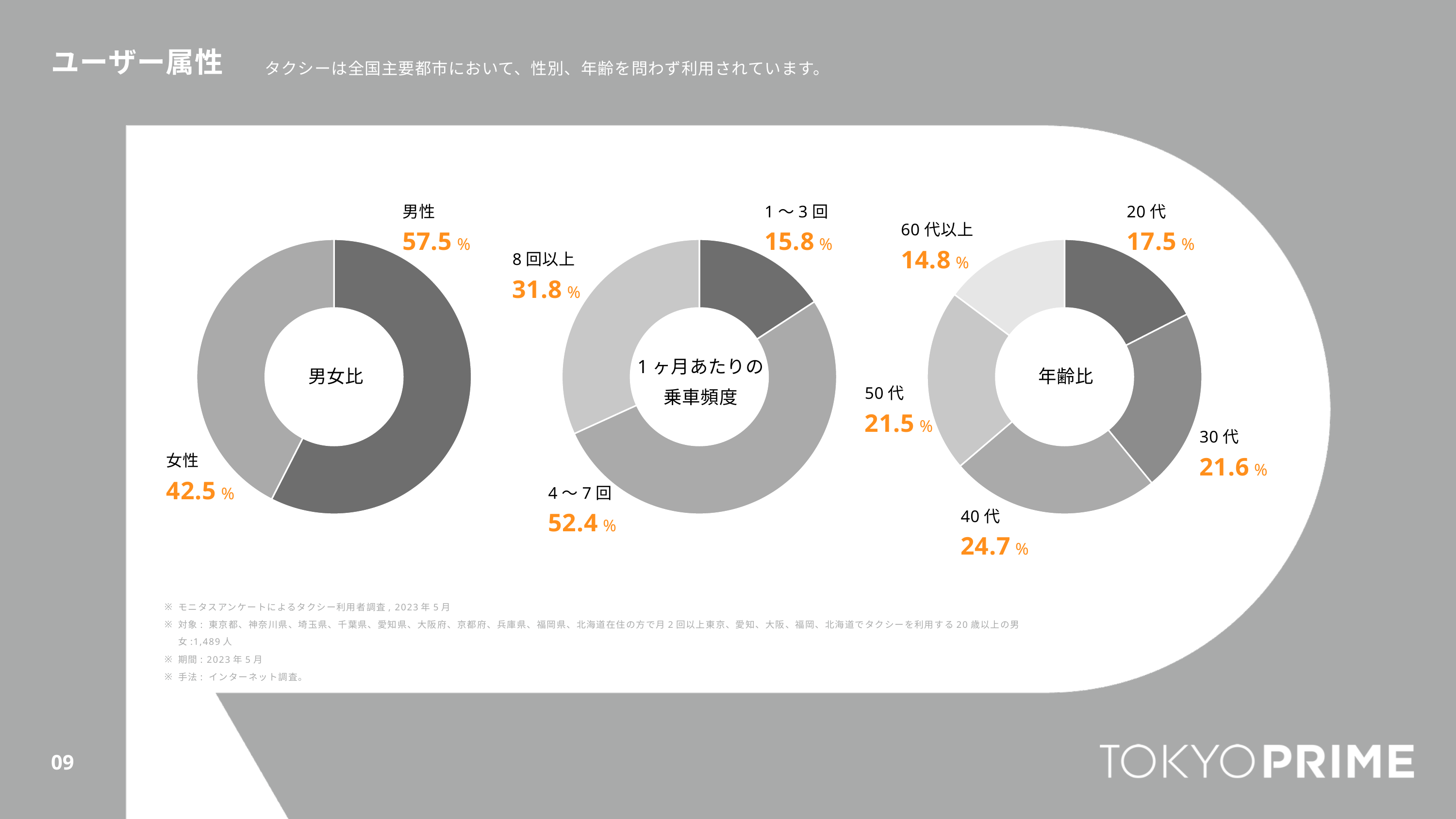
In the 年齢比 chart, which category has the highest value? 40代 In the 1ヶ月あたりの乗車頻度 chart, which category has the lowest value? 1〜3回 In the 年齢比 chart, which is larger, 20代 or 40代? 40代 In the 男女比 chart, what is the value for 女性? 42.5% In the 1ヶ月あたりの乗車頻度 chart, how many categories are shown? 3 What kind of chart is the 年齢比 chart? Donut (pie) chart In the 男女比 chart, what is the value for 男性? 57.5% In the 年齢比 chart, what is the value for 40代? 24.7% In the 1ヶ月あたりの乗車頻度 chart, what is the difference between 8回以上 and 1〜3回? 16.0% In the 男女比 chart, what is the difference between 男性 and 女性? 15.0% In the 年齢比 chart, which category has the lowest value? 60代以上 In the 1ヶ月あたりの乗車頻度 chart, what is the value for 4〜7回? 52.4%